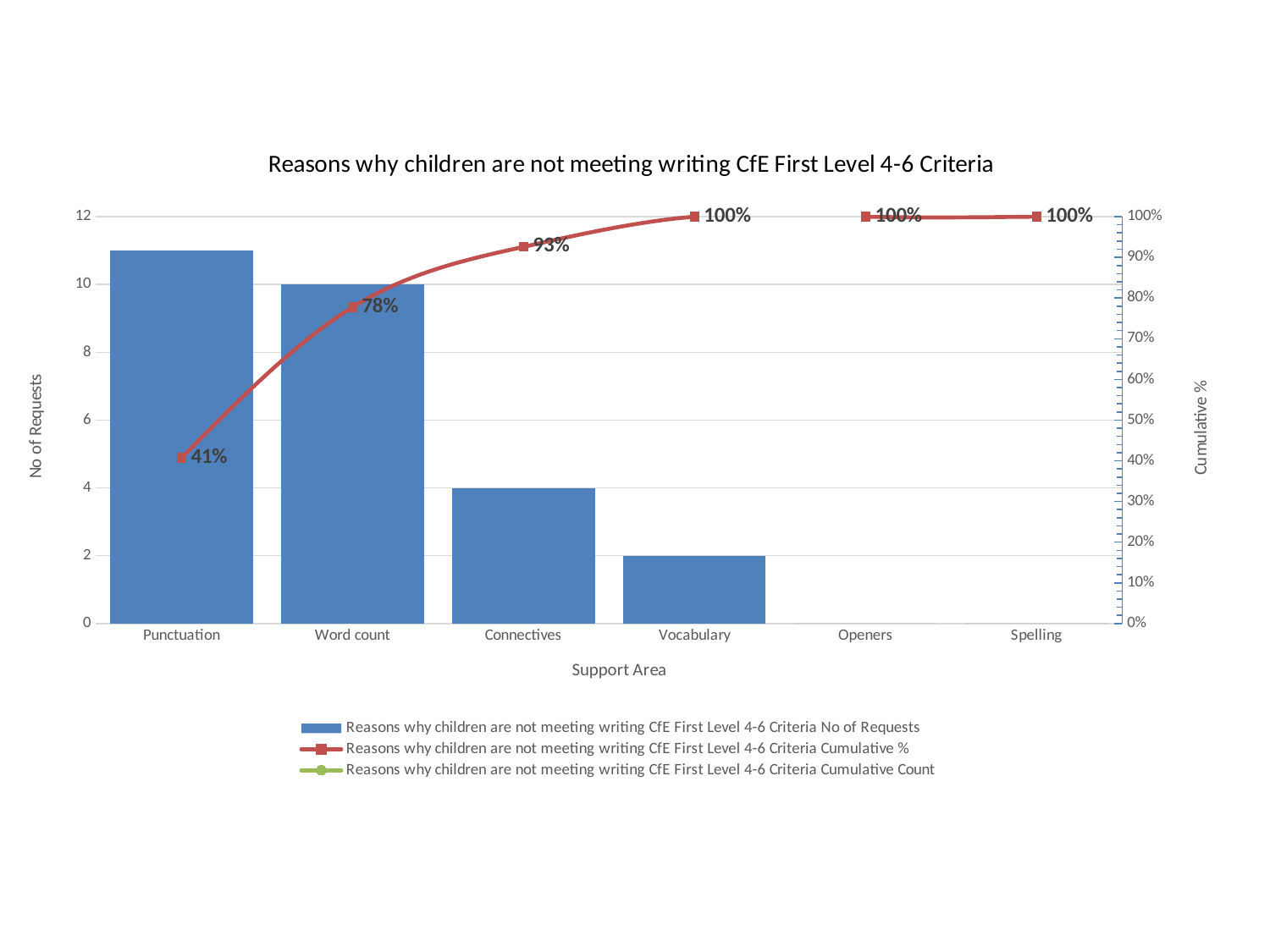
What is the difference in number of requests between Word count and Connectives? 6 What is the number of requests for Vocabulary? 2 What is the cumulative % value for Connectives? 93% How many support areas are shown on the x axis? 6 Which has more requests, Connectives or Vocabulary? Connectives What is the cumulative % value for Word count? 78% What is the number of requests for Word count? 10 Is the number of requests for Punctuation greater or less than 10? greater What is the cumulative % value for Punctuation? 41% Which support area has the highest number of requests? Punctuation What is the number of requests for Connectives? 4 How many series does the legend list? 3